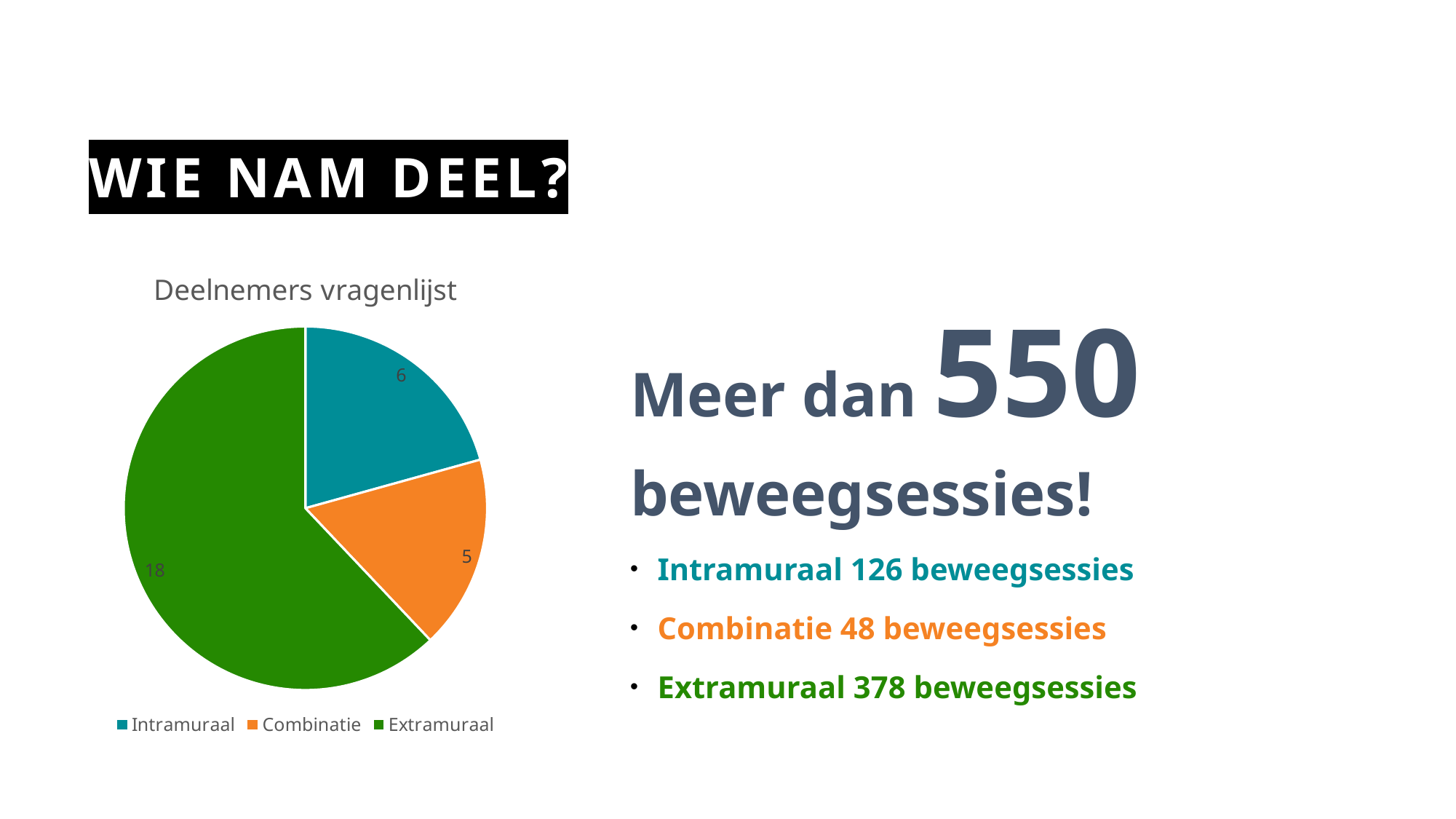
What is the value for Intramuraal in the pie chart? 6 Which is larger in the pie chart, Intramuraal or Combinatie? Intramuraal What is the title of the pie chart? Deelnemers vragenlijst Which category has the smallest slice in the pie chart? Combinatie How many categories does the pie chart show? 3 What is the total of all slices in the pie chart? 29 What type of chart is shown on the slide? Pie chart What is the difference between the Extramuraal and Intramuraal values in the pie chart? 12 Which category has the largest slice in the pie chart? Extramuraal What is the value for Combinatie in the pie chart? 5 What colour is the Extramuraal slice in the pie chart? Green What is the value for Extramuraal in the pie chart? 18